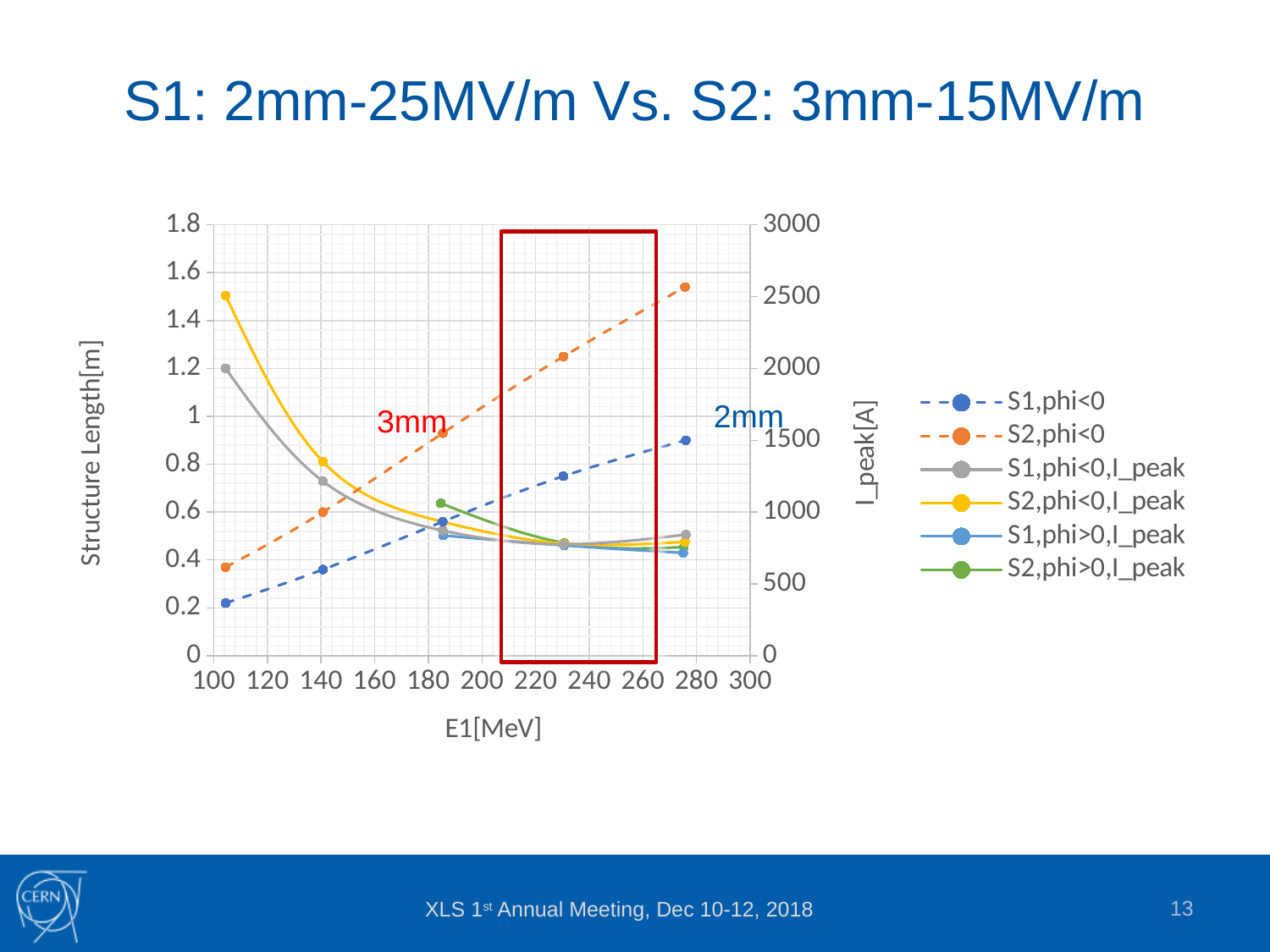
How many series does the chart legend list? 6 How many data points are plotted for the S1,phi<0 series? 5 Does the dashed S1,phi<0 series rise or fall as E1 increases? rise How many data points are plotted for the S2,phi>0,I_peak series? 3 What is the label of the x axis of the chart? E1[MeV] Read against the left axis, is the rightmost point of the S2,phi<0 series greater or less than 1.4? greater Does the dashed S2,phi<0 series rise or fall as E1 increases? rise What kind of chart is shown on the slide? line chart Does the S2,phi<0,I_peak series rise or fall as E1 increases from 100 to 200 MeV? fall At the rightmost data point (E1 near 275 MeV), which is higher on the chart: the S2,phi<0 series or the S1,phi<0 series? S2,phi<0 What is the label of the right-hand y axis of the chart? I_peak[A] Read against the left axis, is the leftmost point of the S1,phi<0 series greater or less than 0.4? less